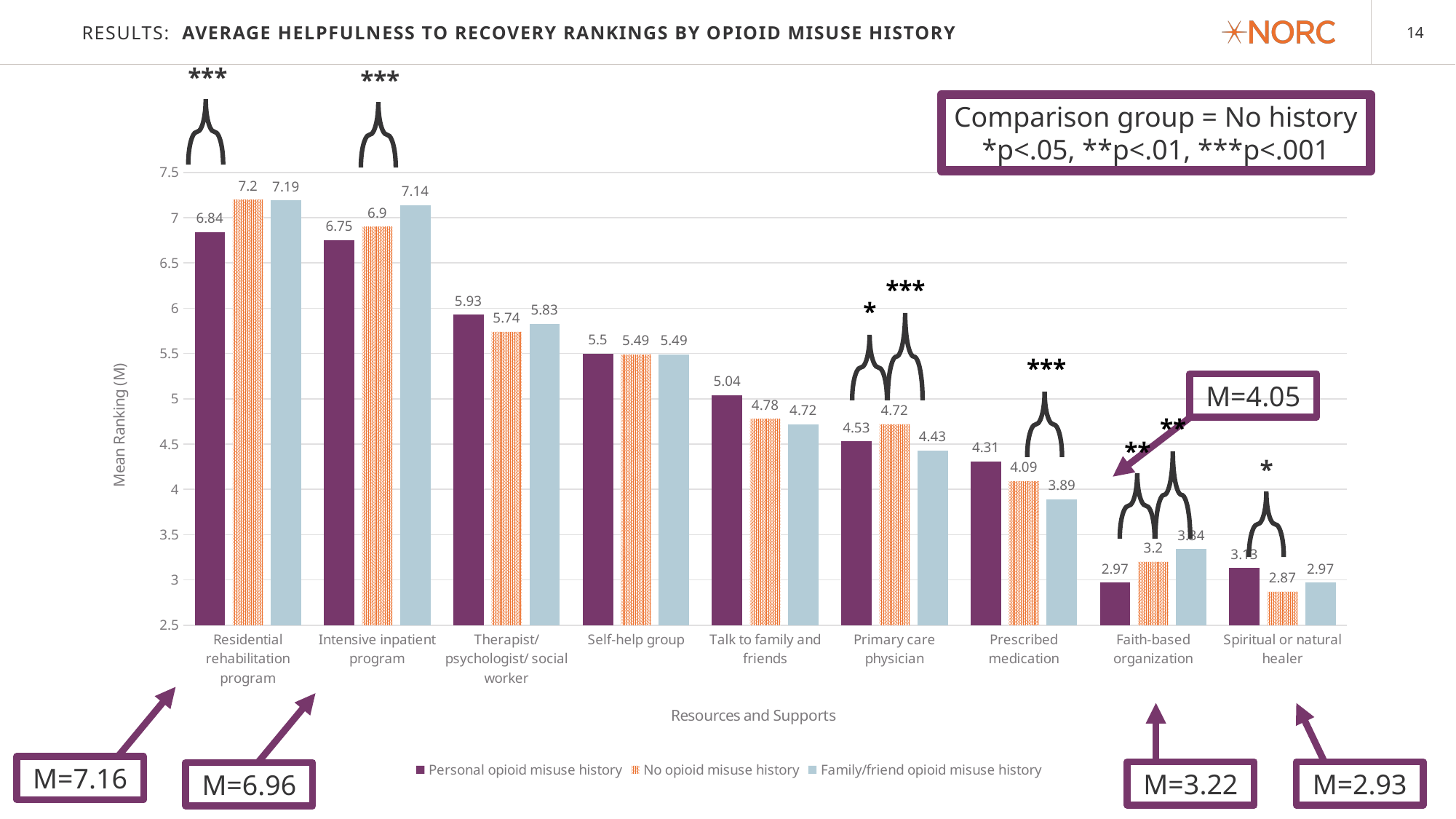
How many series does the legend list? 3 How many resources and supports are shown on the x axis? 9 What is the label of the y axis? Mean Ranking (M) What kind of chart is shown on the slide? Bar chart Which resource has the highest mean ranking for the No opioid misuse history series? Residential rehabilitation program Which resource has the lowest mean ranking for the Personal opioid misuse history series? Faith-based organization What is the mean ranking for Prescribed medication among respondents with no opioid misuse history? 4.09 What is the mean ranking for Faith-based organization among respondents with a family/friend opioid misuse history? 3.34 What is the difference between the Personal opioid misuse history and No opioid misuse history mean rankings for Talk to family and friends? 0.26 For Primary care physician, which series has the larger mean ranking: Personal opioid misuse history or No opioid misuse history? No opioid misuse history What is the mean ranking for Self-help group among respondents with a personal opioid misuse history? 5.5 Do the mean rankings for the Family/friend opioid misuse history series generally rise or fall from left to right across the x axis? Fall